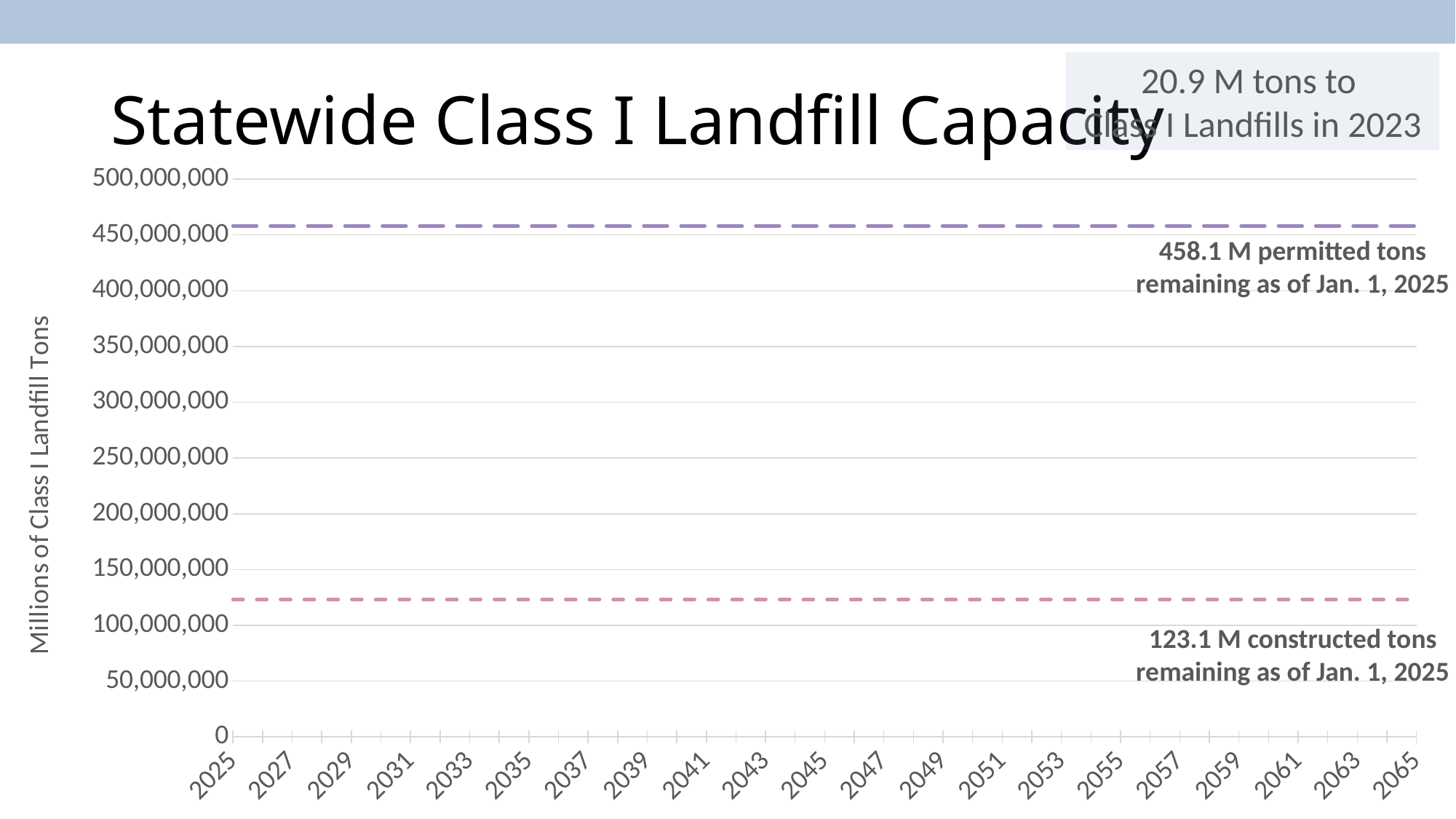
What kind of chart is shown on the slide? line chart Is the constructed tons remaining line greater or less than 150,000,000? less How many year labels are shown on the x axis? 21 Is the permitted tons remaining line above or below the 450,000,000 gridline? above What is the label of the y axis? Millions of Class I Landfill Tons How many permitted tons remain as of Jan. 1, 2025, according to the upper dashed line's label? 458.1 M Which is larger: the permitted tons remaining or the constructed tons remaining? permitted tons remaining What is the first year shown on the x axis? 2025 What is the difference between the permitted tons remaining (458.1 M) and the constructed tons remaining (123.1 M)? 335.0 M Do the dashed lines rise, fall, or stay flat from 2025 to 2065? stay flat What is the last year shown on the x axis? 2065 How many constructed tons remain as of Jan. 1, 2025, according to the lower dashed line's label? 123.1 M